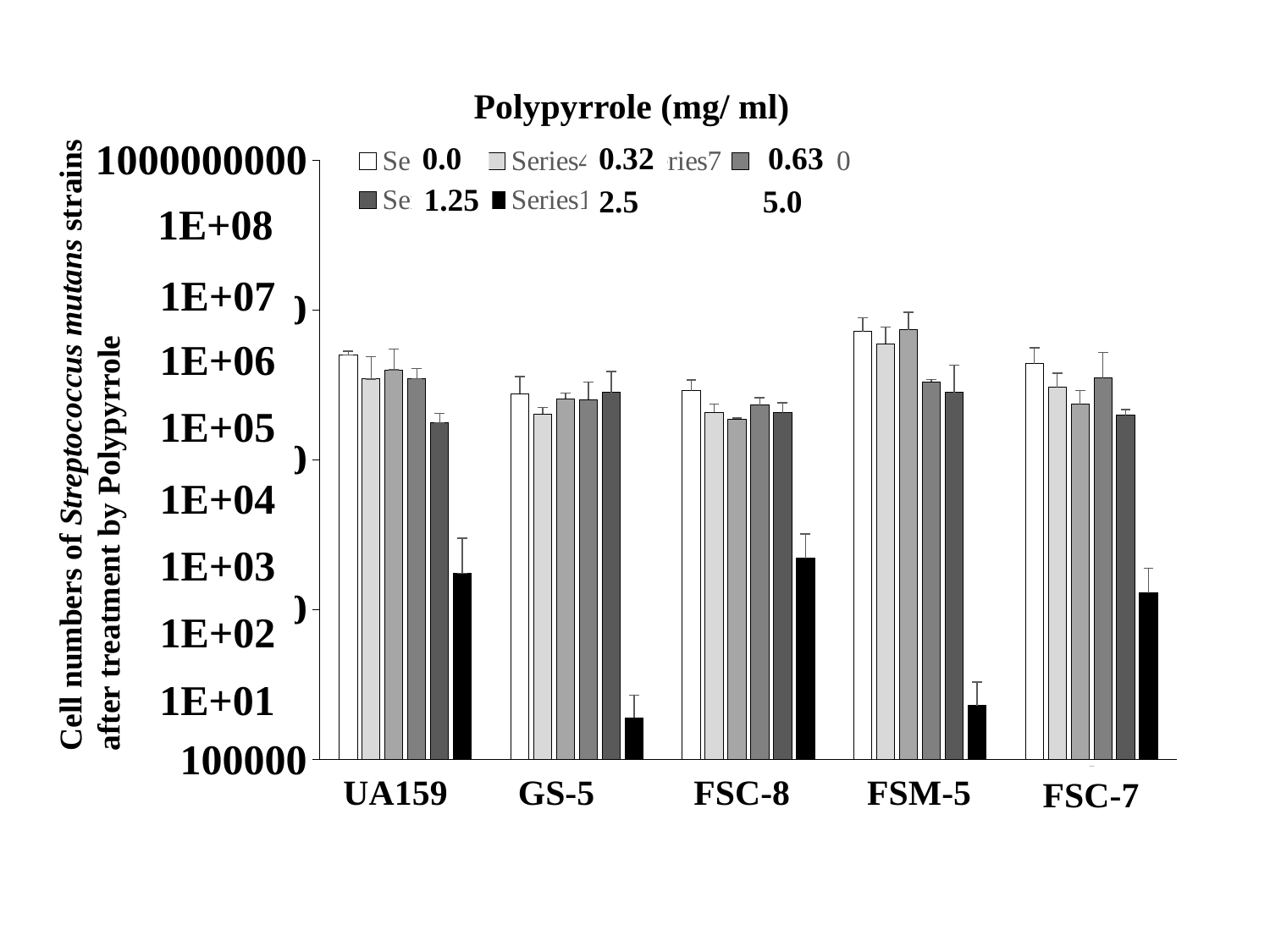
What kind of chart is shown on the slide? bar chart Is the 0.0 mg/ml bar for FSM-5 larger or smaller than the 0.0 mg/ml bar for UA159? larger Within the UA159 group, do the bars generally rise or fall as the polypyrrole concentration increases from 0.0 to 5.0 mg/ml? fall What is the title shown above the chart? Polypyrrole (mg/ ml) Is the value for the 0.0 mg/ml bar of FSM-5 greater or less than 1E+06? greater How many polypyrrole concentrations does the legend list? 6 Which strain has the highest bar at 0.0 mg/ml polypyrrole? FSM-5 How many Streptococcus mutans strains are shown along the x axis? 5 Is the value for the 5.0 mg/ml bar of UA159 greater or less than 1E+02? greater What colour are the bars for the 5.0 mg/ml polypyrrole series? black